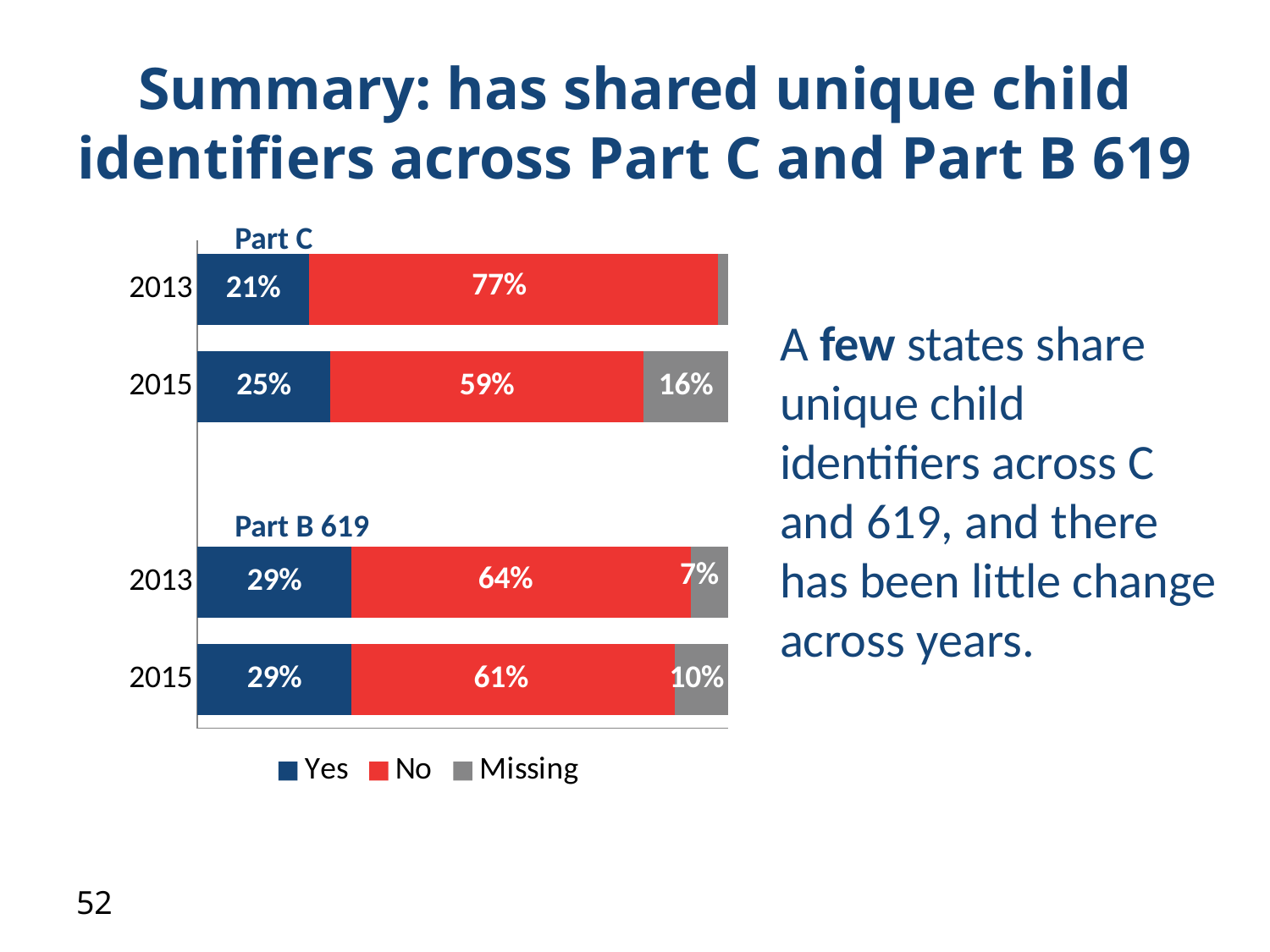
What percentage of states answered No for Part C in 2013? 77% Is the Missing share larger for Part C 2015 or Part B 619 2015? Part C 2015 What percentage answered No for Part B 619 in 2013? 64% What colour represents the Yes series in the chart? Dark blue How many series does the legend list? 3 What percentage of states answered Yes for Part C in 2015? 25% What is the Missing share for Part B 619 in 2015? 10% Which bar has the lowest Yes percentage? Part C 2013 What is the difference between the No percentage for Part C in 2013 and in 2015? 18% Which bar has the highest No percentage? Part C 2013 What kind of chart is shown on the slide? Stacked bar chart How many bars are plotted in the chart? 4